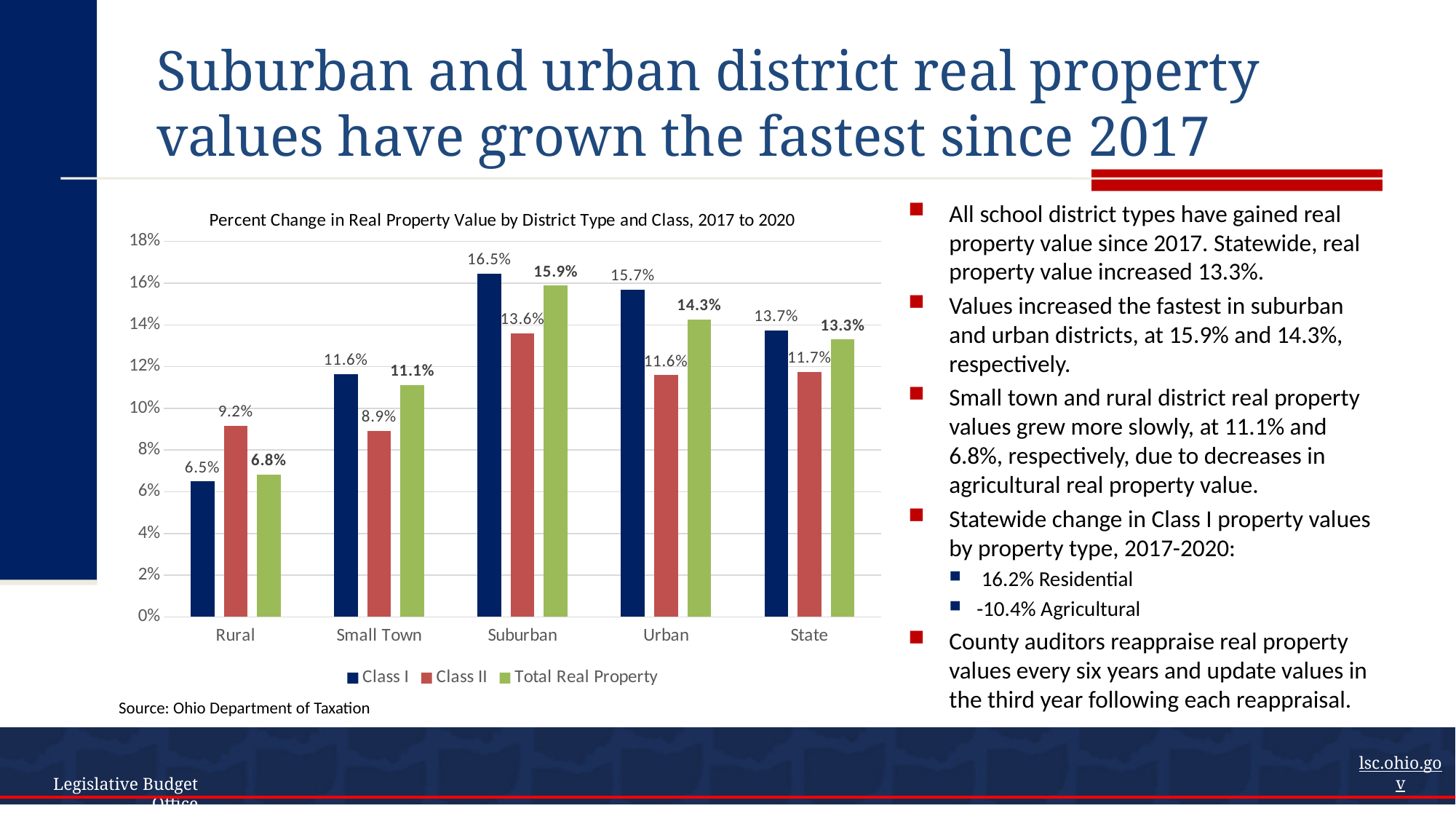
How many district type categories are shown on the x axis? 5 What is the title of the chart? Percent Change in Real Property Value by District Type and Class, 2017 to 2020 Which district type has the lowest Class I value? Rural What is the difference between the Class I and Class II values for Urban districts? 4.1% What is the Class II value for Small Town districts? 8.9% What is the Total Real Property value for Rural districts? 6.8% What is the Class I value for Suburban districts? 16.5% What kind of chart is shown on the slide? Bar chart How many series does the legend list? 3 Which district type has the highest Total Real Property value? Suburban For Rural districts, which is larger: the Class I value or the Class II value? Class II Is the Class II value for Suburban districts greater or less than 12%? greater